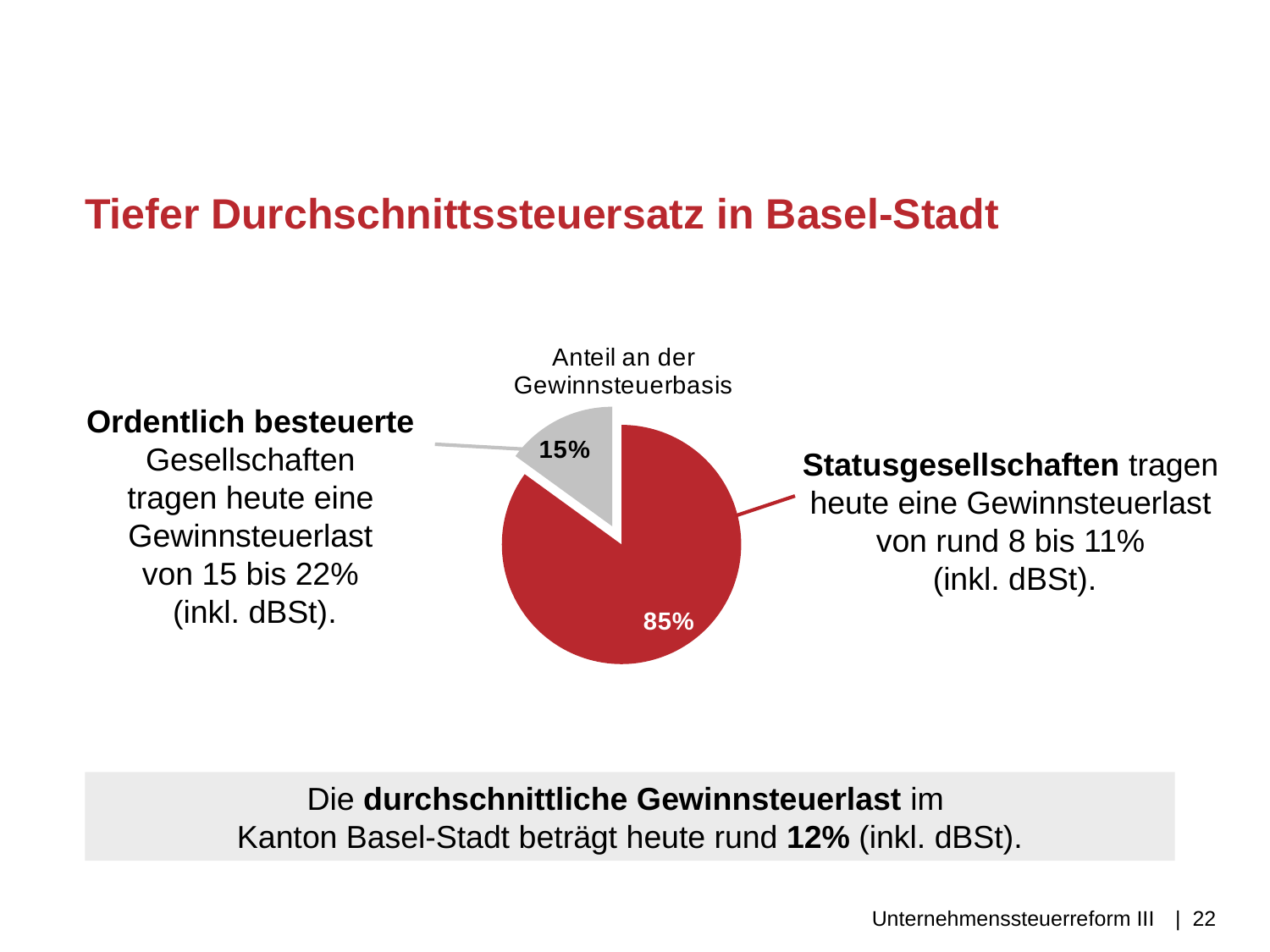
What share of the Gewinnsteuerbasis do the Statusgesellschaften account for in the pie chart? 85% Which slice of the pie chart is the largest? Statusgesellschaften (85%) What is the title of the pie chart? Anteil an der Gewinnsteuerbasis What is the value printed on the red slice of the pie chart? 85% What is the difference in percentage points between the two slices of the pie chart? 70 percentage points How many slices does the pie chart have? 2 What kind of chart is shown on the slide? pie chart Which slice of the pie chart is the smallest? Ordentlich besteuerte Gesellschaften (15%) What colour is the slice representing the Statusgesellschaften in the pie chart? red What is the value printed on the grey slice of the pie chart? 15% What share of the Gewinnsteuerbasis do the ordentlich besteuerte Gesellschaften account for in the pie chart? 15% Which is larger in the pie chart: the share of Statusgesellschaften or the share of ordentlich besteuerte Gesellschaften? Statusgesellschaften